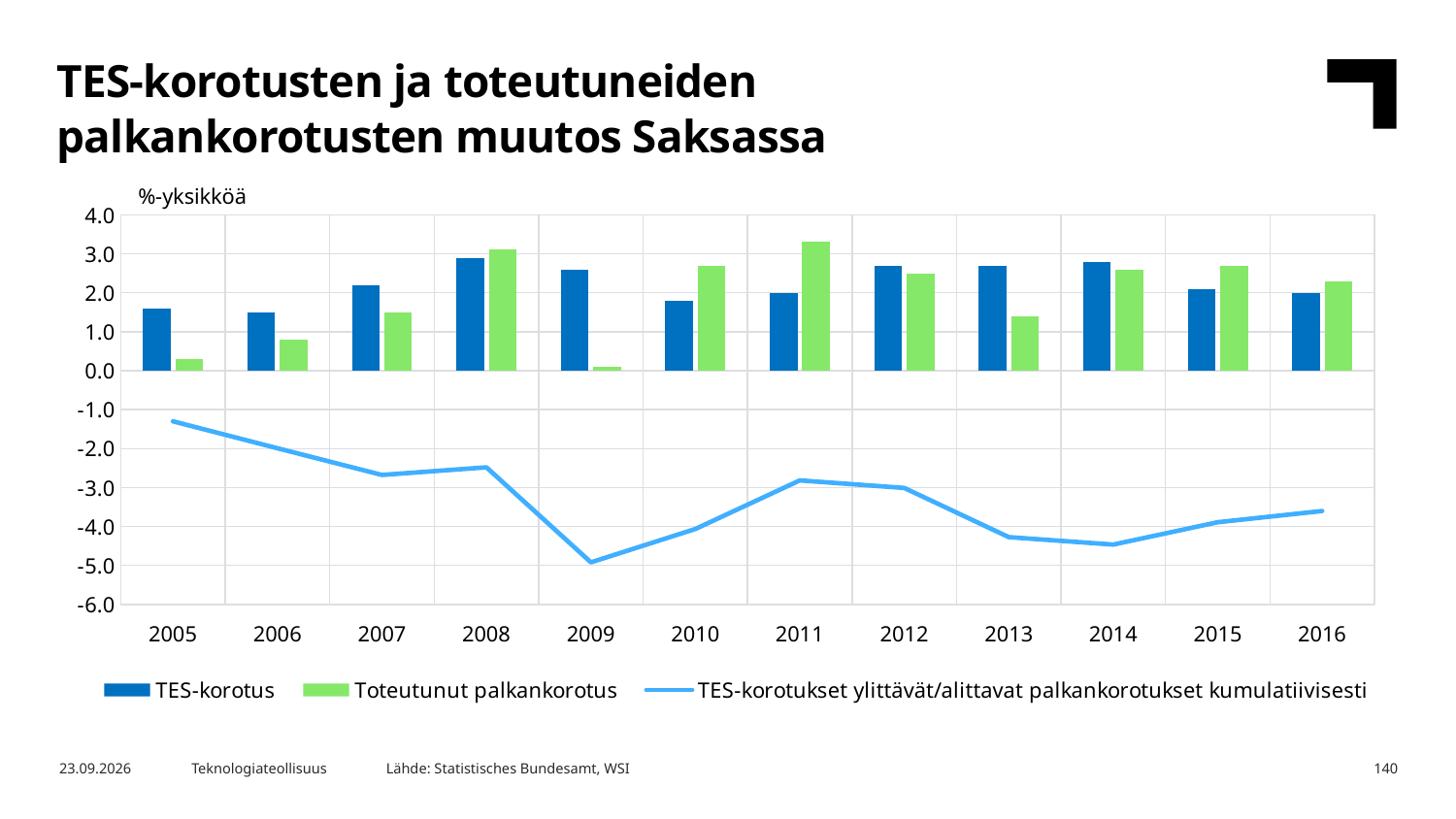
In which year does the line 'TES-korotukset ylittävät/alittavat palkankorotukset kumulatiivisesti' reach its lowest point? 2009 What unit label is shown above the vertical axis of the chart? %-yksikköä In 2011, which is larger: TES-korotus or Toteutunut palkankorotus? Toteutunut palkankorotus How many years are shown on the x axis of the chart? 12 What kind of chart is shown on the slide? Combined bar and line chart In 2013, which is larger: TES-korotus or Toteutunut palkankorotus? TES-korotus Is the TES-korotus value for 2008 greater or less than 2.0? greater In which year is the Toteutunut palkankorotus bar the lowest? 2009 Is the Toteutunut palkankorotus value for 2005 greater or less than 1.0? less Is the cumulative line value for 2009 greater or less than -4.0? less How many series does the chart legend list? 3 Does the cumulative line rise or fall between 2008 and 2009? fall